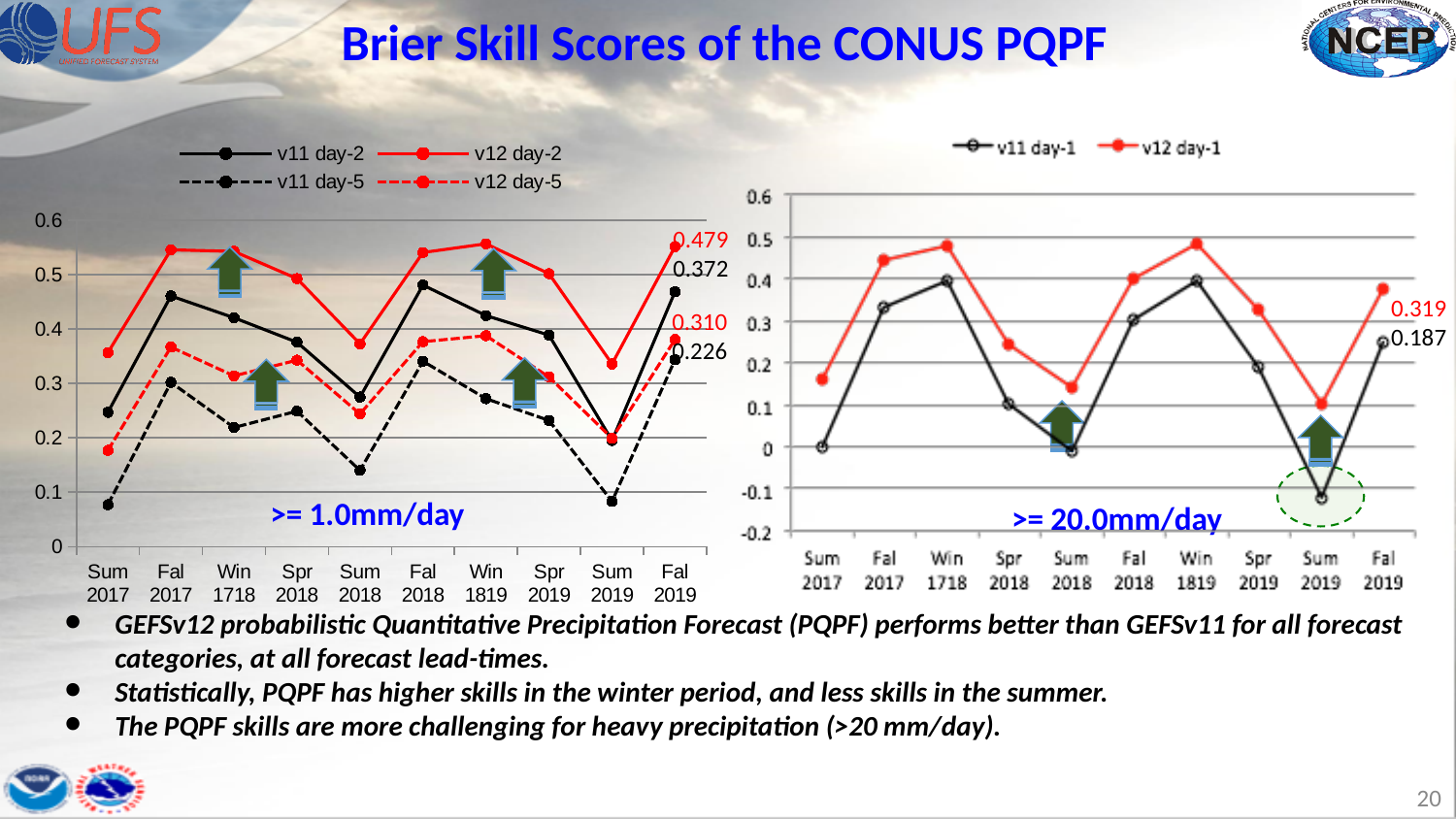
On the right chart (>= 20.0mm/day), at which season is the v11 day-1 series lowest? Sum 2019 How many series does the legend of the right chart (>= 20.0mm/day) list? 2 On the right chart (>= 20.0mm/day), is the value for v11 day-1 at Sum 2019 greater or less than 0? less What kind of chart is the right chart (>= 20.0mm/day)? Line chart How many series does the legend of the left chart (>= 1.0mm/day) list? 4 How many season categories are shown on the x axis of the left chart (>= 1.0mm/day)? 10